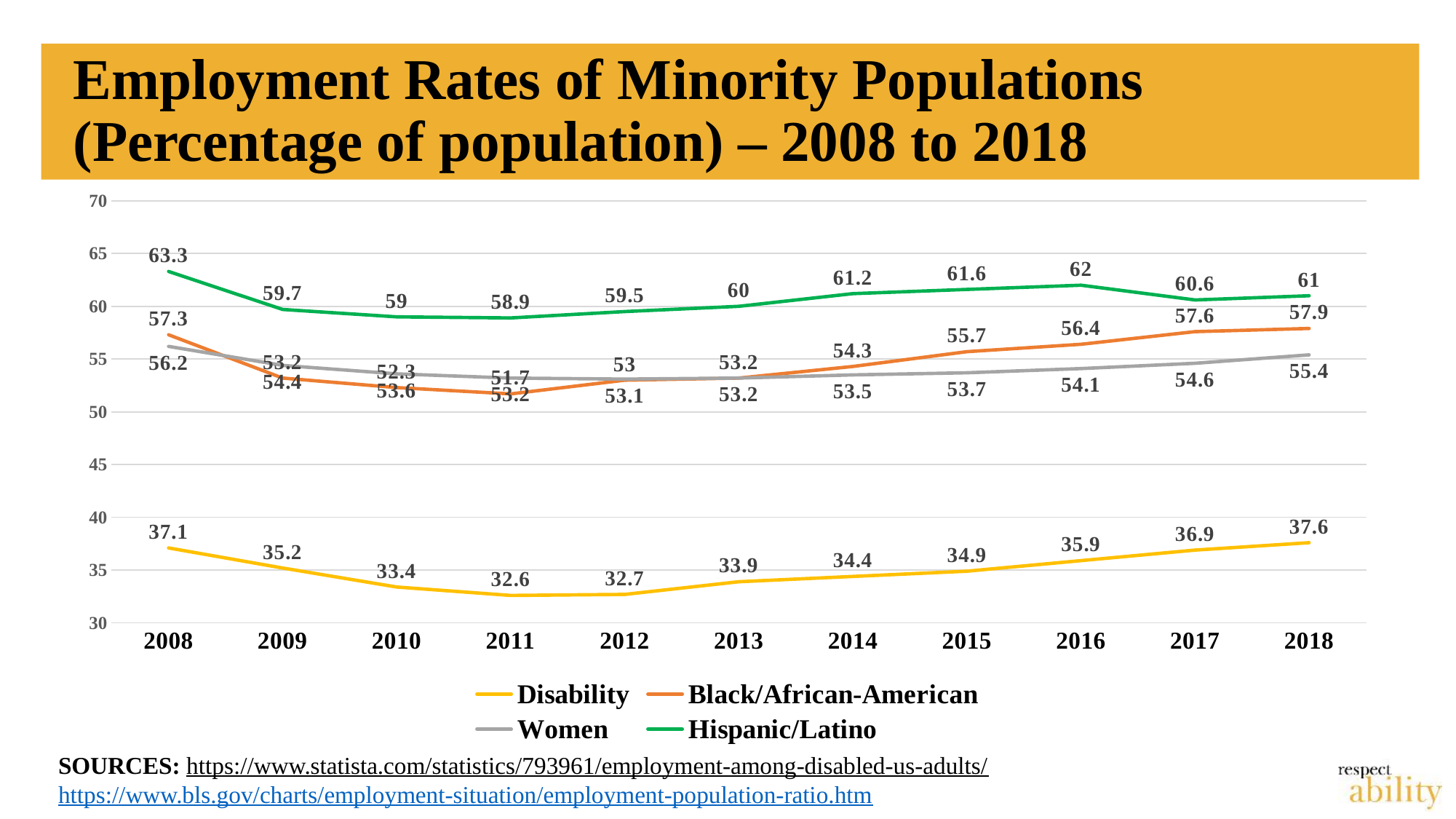
Does the Disability employment rate rise or fall from 2011 to 2018? Rise How many years are plotted along the x axis? 11 Which series has the higher value in 2018, Black/African-American or Women? Black/African-American In which year is the Hispanic/Latino employment rate highest? 2008 What is the employment rate for Disability in 2011? 32.6 In which year is the Disability employment rate lowest? 2011 What is the difference between the Disability employment rate in 2018 and in 2008? 0.5 What is the employment rate for Hispanic/Latino in 2008? 63.3 What is the employment rate for Women in 2008? 56.2 How many series does the legend list? 4 What is the employment rate for Black/African-American in 2018? 57.9 What type of chart is shown on the slide? Line chart